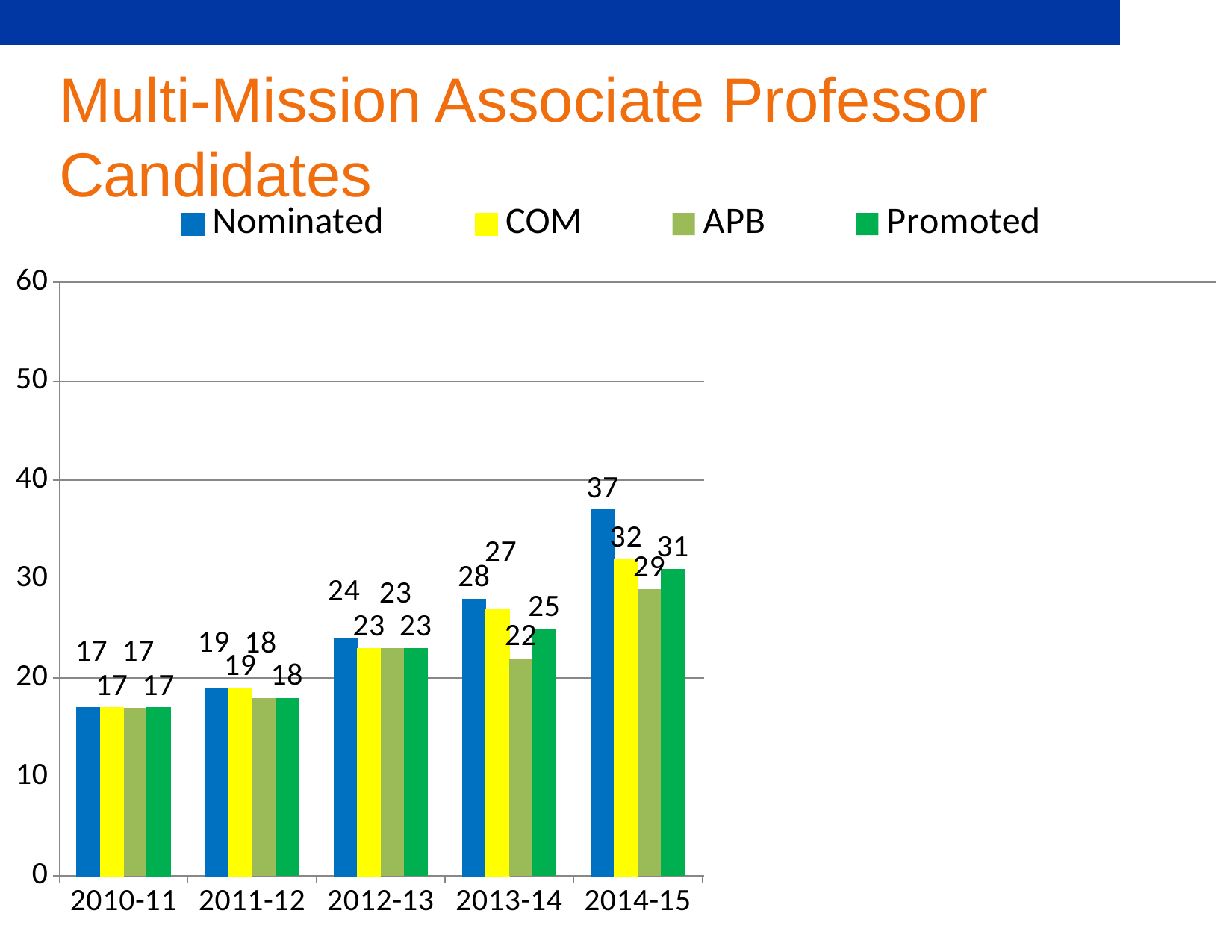
Which is larger in 2013-14, the COM value or the APB value? COM What is the Nominated value for 2014-15? 37 What is the Promoted value for 2012-13? 23 How many years are shown on the x axis? 5 Which year has the highest Nominated value? 2014-15 Which year has the lowest Promoted value? 2010-11 What is the APB value for 2013-14? 22 What is the COM value for 2011-12? 19 Do the Nominated values rise or fall from 2010-11 to 2014-15? Rise How many series does the legend list? 4 What is the difference between the Nominated and Promoted values for 2014-15? 6 What kind of chart is shown on the slide? Bar chart